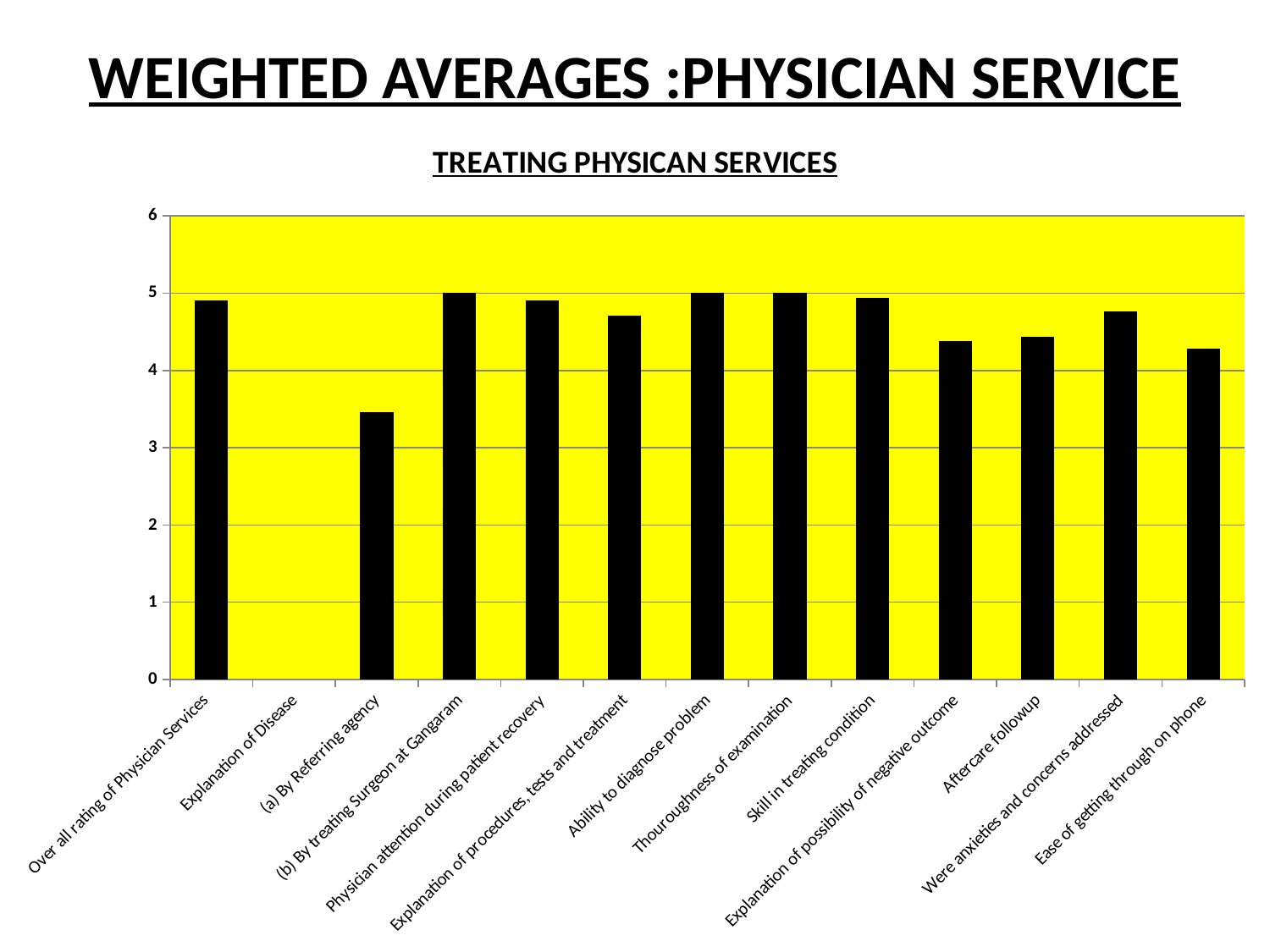
Which is larger, the value for Were anxieties and concerns addressed or the value for Ease of getting through on phone? Were anxieties and concerns addressed How many bars are plotted in the chart? 12 What is the highest value shown on the vertical axis? 6 Is the value for Explanation of possibility of negative outcome greater or less than 5? less Is the value for Explanation of procedures, tests and treatment greater or less than 5? less Is the value for (a) By Referring agency greater or less than 4? less Which category has the lowest bar? (a) By Referring agency Which is larger, the value for (a) By Referring agency or the value for Aftercare followup? Aftercare followup What kind of chart is shown on the slide? bar chart What is the title of the chart? TREATING PHYSICAN SERVICES